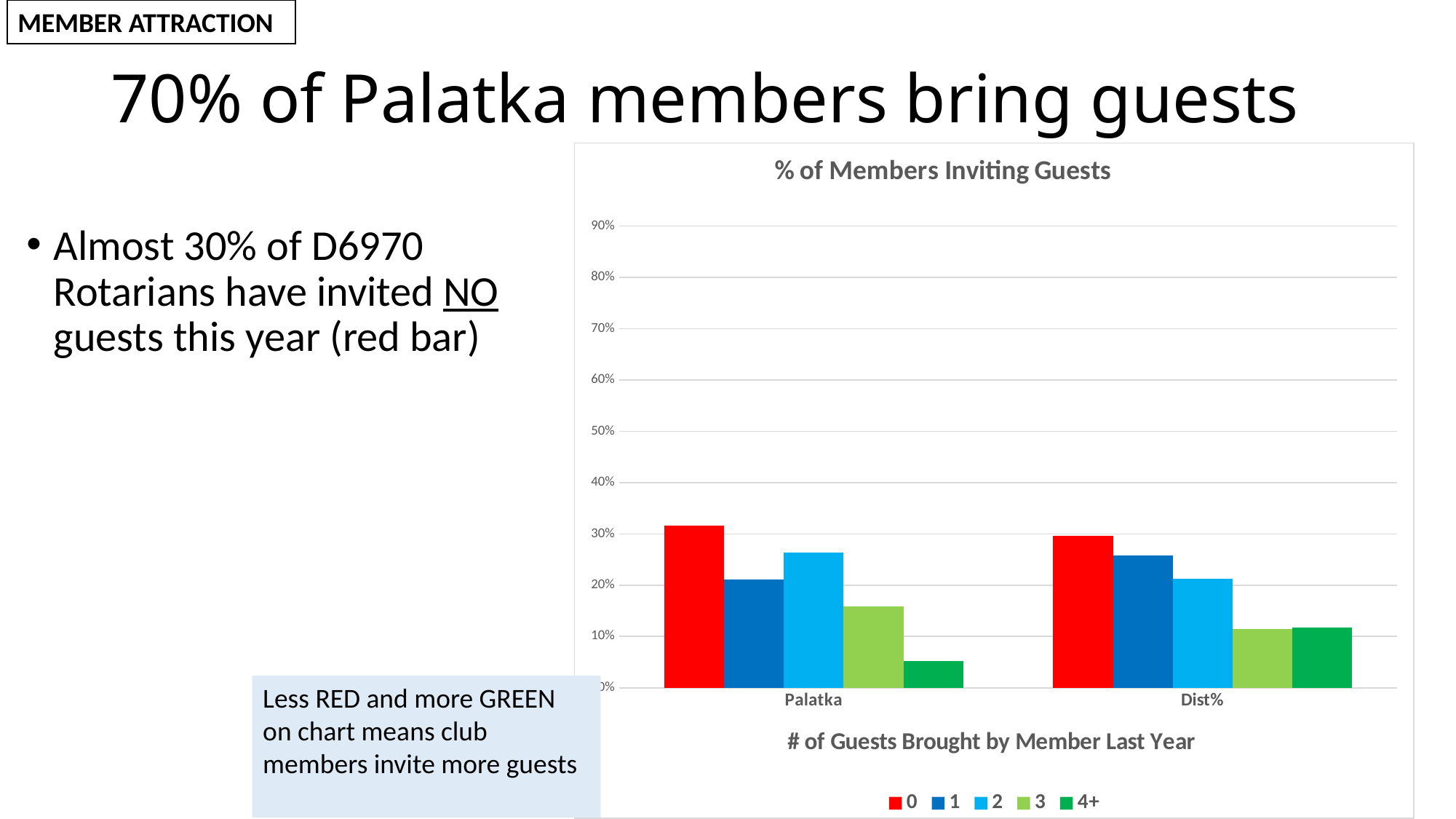
Is the value for the 4+ series for Palatka greater or less than 10%? less What kind of chart is shown on the slide? bar chart Which series has the highest value for Palatka? 0 Which is larger: the 3 value for Palatka or the 3 value for Dist%? Palatka How many categories are shown on the x axis of the chart? 2 Which is larger: the 4+ value for Palatka or the 4+ value for Dist%? Dist% What is the x-axis label of the chart? # of Guests Brought by Member Last Year How many series does the chart legend list? 5 Is the value for the 2 series for Palatka greater or less than 20%? greater Which series has the lowest value for Palatka? 4+ What is the title of the chart? % of Members Inviting Guests Which series has the highest value for Dist%? 0